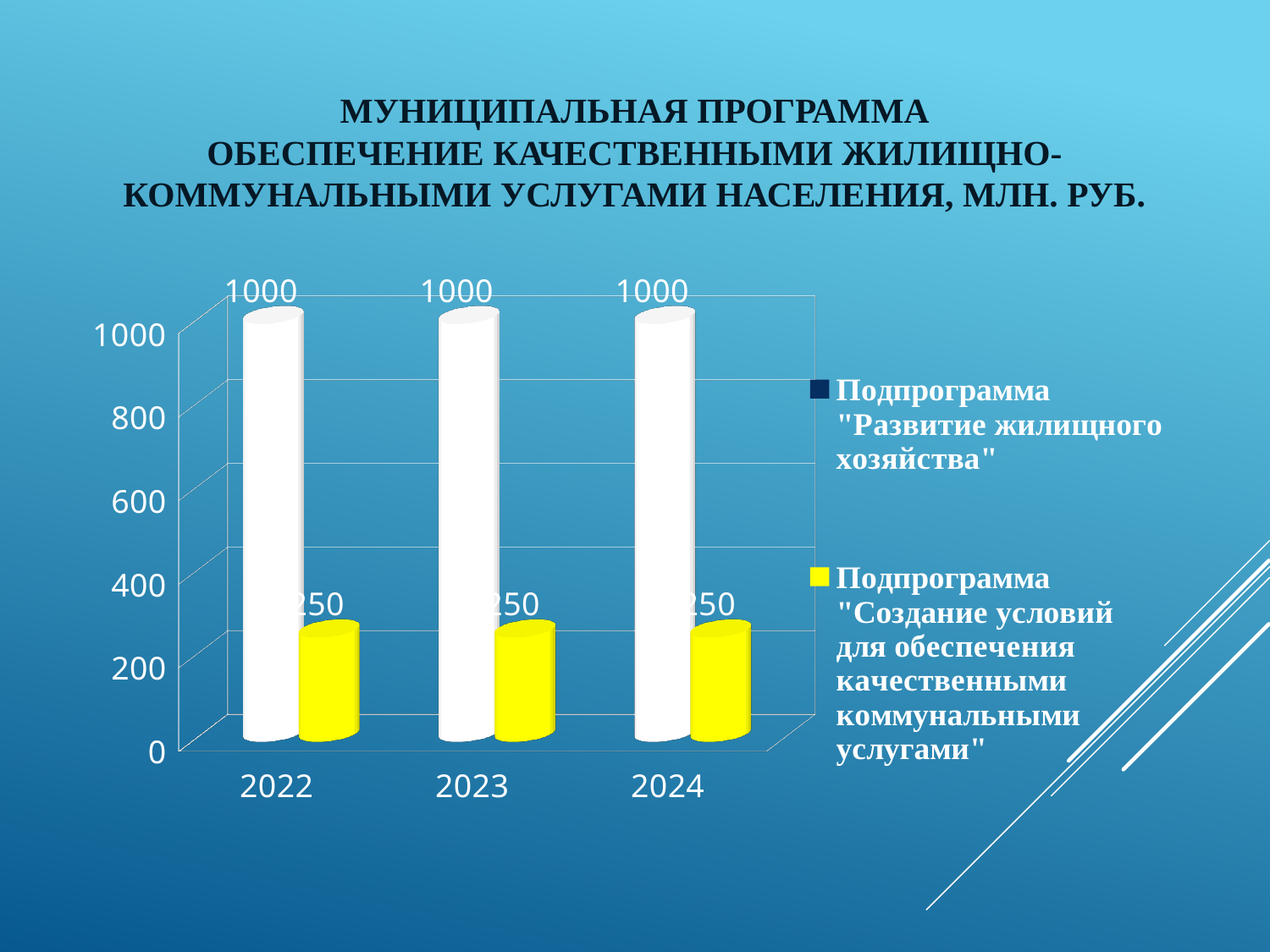
What is the difference between the two subprograms' values in 2023? 750 Is the value for the subprogram "Создание условий для обеспечения качественными коммунальными услугами" in 2023 greater or less than 400? less How many series does the legend list? 2 What is the value for the subprogram "Создание условий для обеспечения качественными коммунальными услугами" in 2024? 250 What is the combined value of both subprograms in 2022? 1250 In what units are the values on the chart expressed, according to the title? млн. руб. Which subprogram has the larger value in 2024? Подпрограмма "Развитие жилищного хозяйства" How many years are shown on the x axis? 3 What kind of chart is shown on the slide? Bar chart What is the value for the subprogram "Развитие жилищного хозяйства" in 2023? 1000 What is the value for the subprogram "Развитие жилищного хозяйства" in 2022? 1000 Do the values for the subprogram "Развитие жилищного хозяйства" rise, fall or stay the same from 2022 to 2024? Stay the same